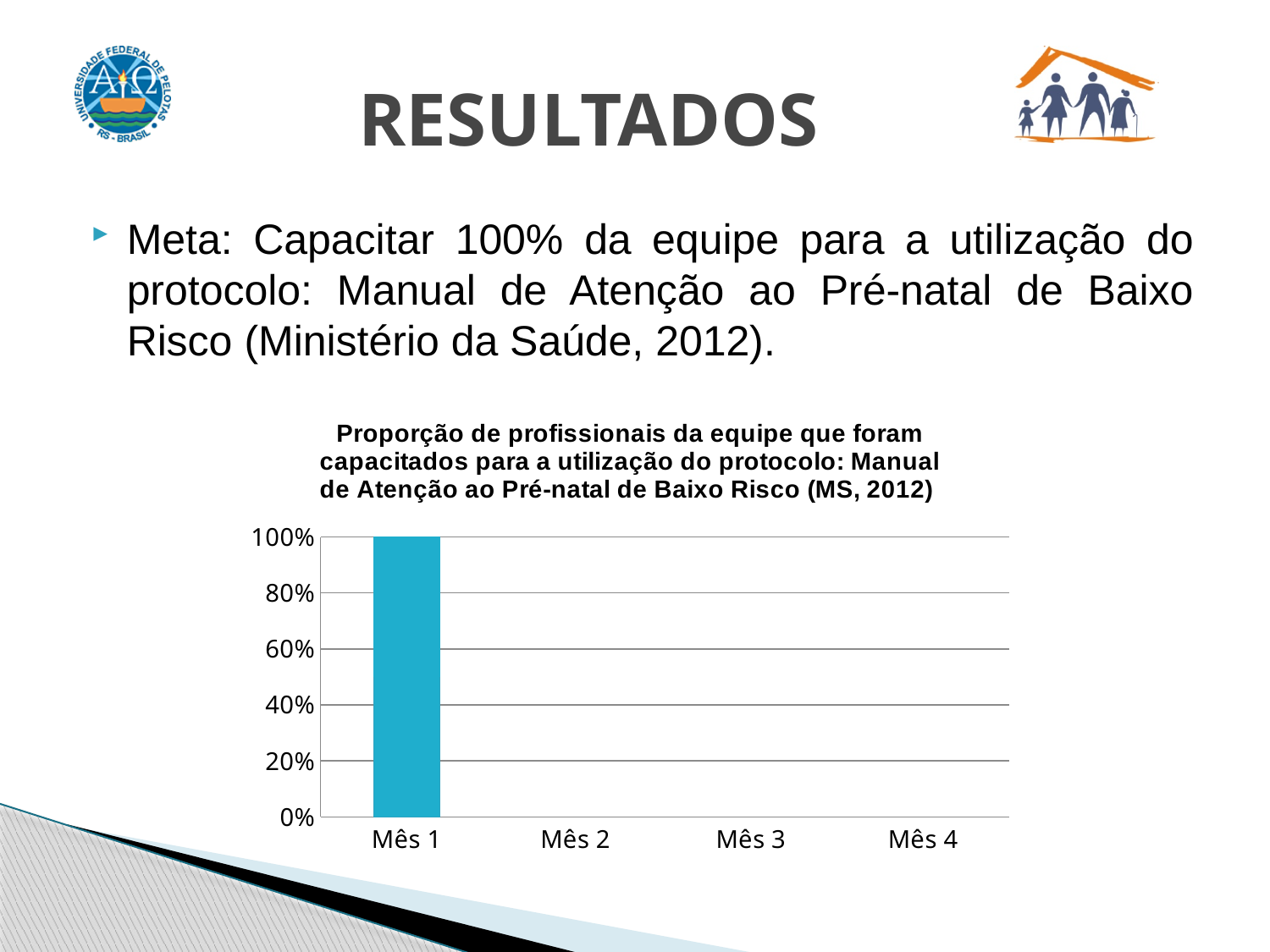
Is the value for Mês 1 greater or less than 80%? greater What is the value for Mês 1? 100% Which is larger, the value for Mês 1 or the value for Mês 2? Mês 1 What kind of chart is shown on the slide? bar chart What is the highest value shown on the y axis? 100% How many months have a visible bar in the chart? 1 Which month has the highest value? Mês 1 What is the label of the first category on the x axis? Mês 1 How many months are shown on the x axis? 4